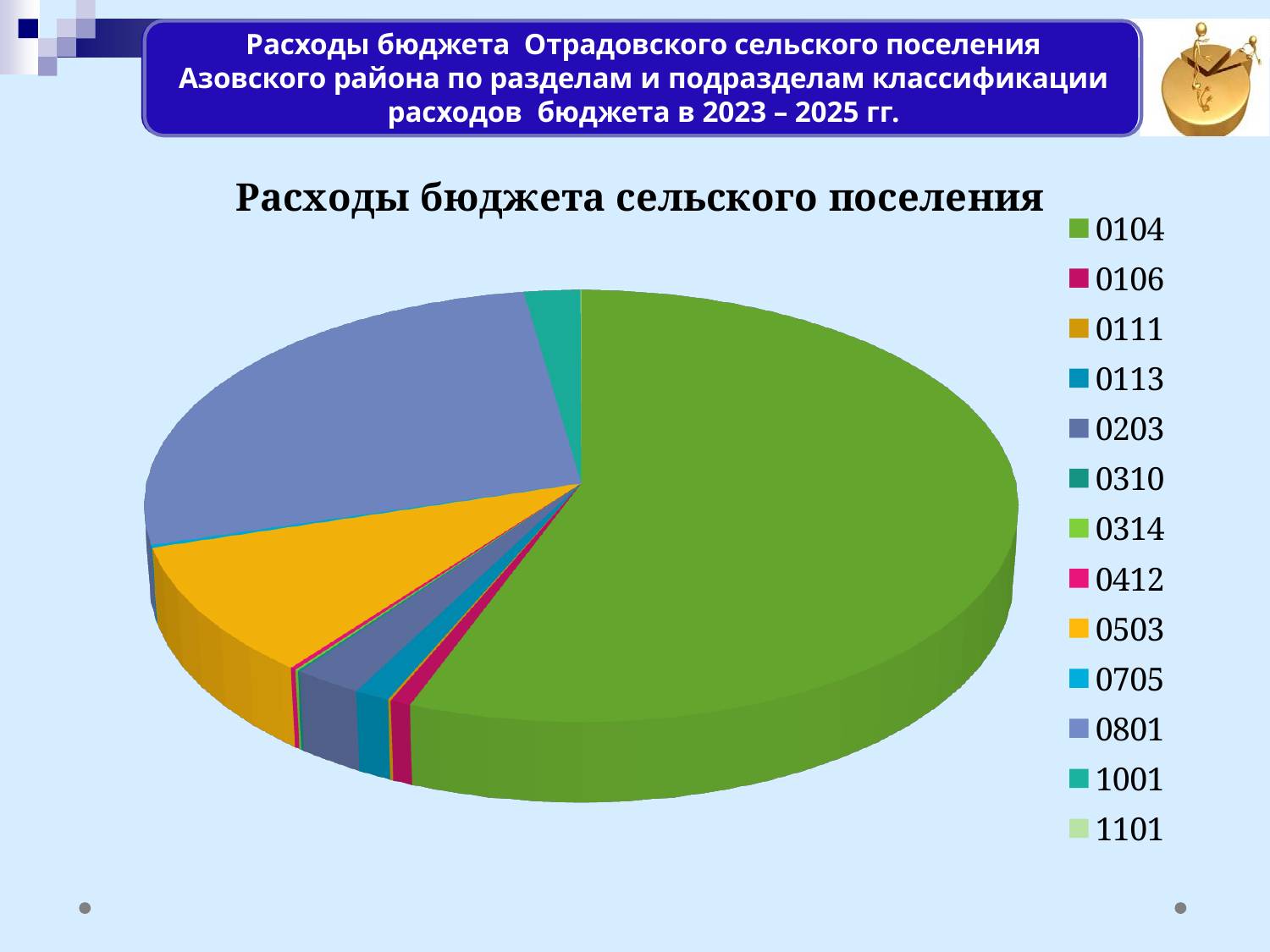
Which is larger in the pie chart, the slice for 0503 or the slice for 1001? 0503 Which is larger in the pie chart, the slice for 0801 or the slice for 0503? 0801 What is the title of the pie chart? Расходы бюджета сельского поселения What kind of chart is shown on the slide? pie chart Which category has the largest slice in the pie chart? 0104 Which is larger in the pie chart, the slice for 0104 or the slice for 0801? 0104 How many categories does the legend of the pie chart list? 13 What colour is the slice for category 0104 in the pie chart? green